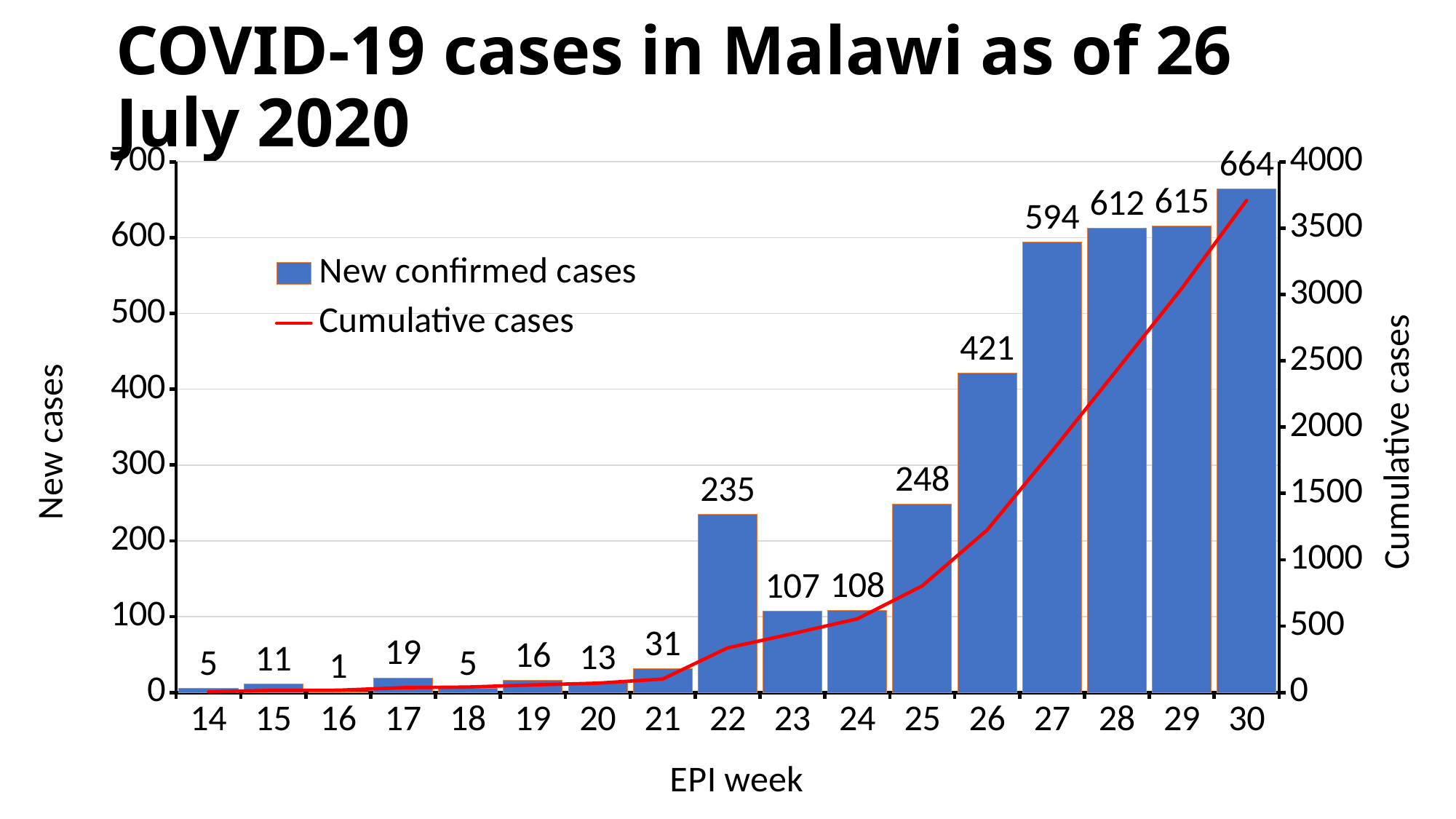
Which EPI week has the highest number of new confirmed cases? 30 How many EPI weeks are shown on the x axis? 17 How many new confirmed cases are shown for EPI week 22? 235 Which EPI week has more new confirmed cases, week 22 or week 25? 25 How many series does the legend list? 2 What is the difference in new confirmed cases between EPI week 30 and EPI week 27? 70 What is the title of the chart? COVID-19 cases in Malawi as of 26 July 2020 What kind of chart is used for the new confirmed cases? bar chart Does the cumulative cases line rise or fall from EPI week 14 to EPI week 30? rise Which EPI week has the lowest number of new confirmed cases? 16 Is the cumulative cases value at EPI week 30 greater or less than 3500? greater How many new confirmed cases are shown for EPI week 26? 421